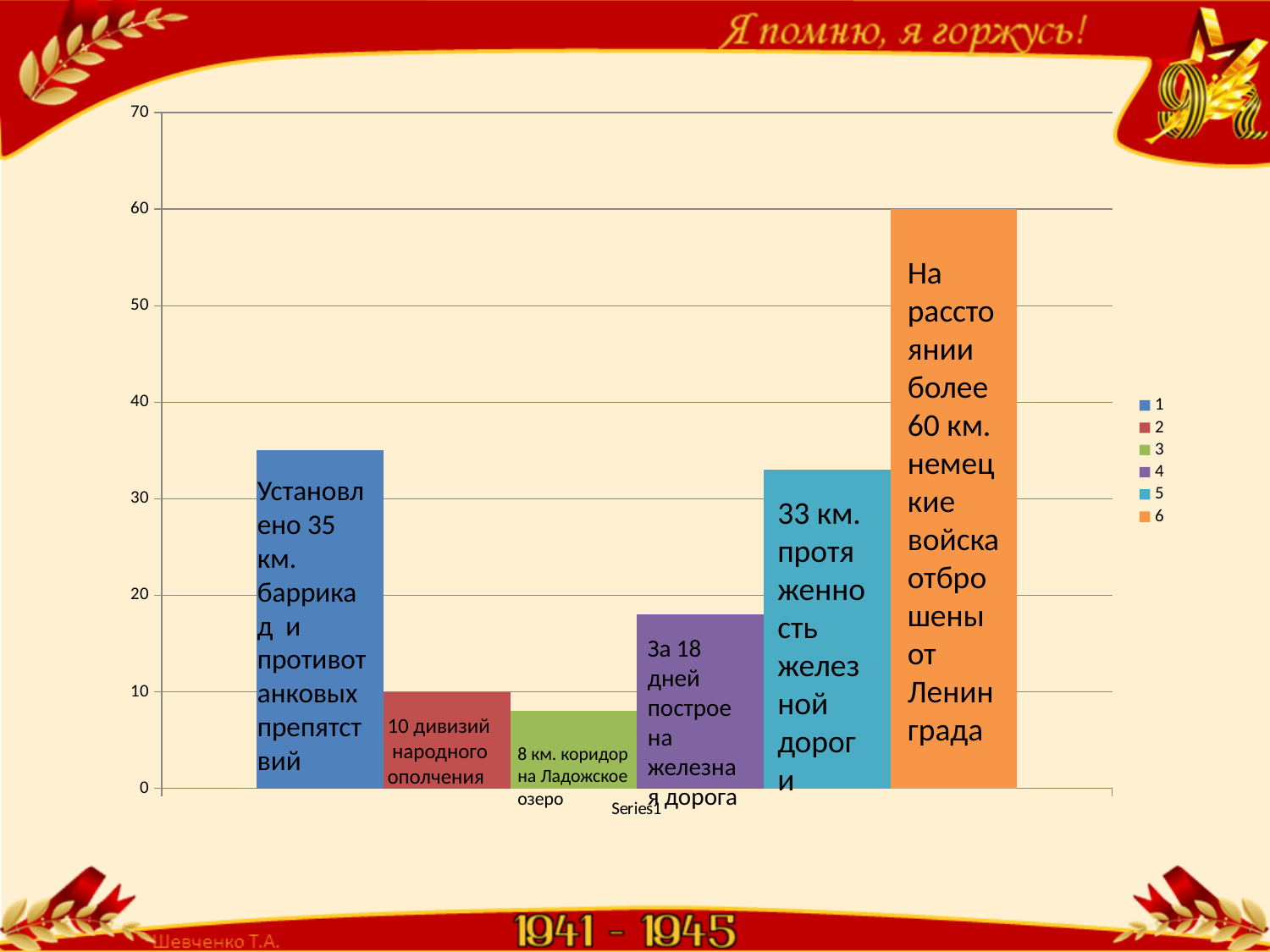
Is the value of the bar for series 1 (the blue bar) greater or less than 30? greater What is the value of the bar for series 6 (the orange bar)? 60 What is the value of the bar for series 2 (the red bar)? 10 Which bar is taller: series 4 (purple) or series 2 (red)? series 4 Is the value of the bar for series 5 (the teal bar) greater or less than 30? greater How many entries does the chart legend list? 6 Which legend series has the tallest bar in the chart? 6 How many bars are plotted in the chart? 6 Which legend series has the shortest bar in the chart? 3 What kind of chart is shown on the slide? bar chart Is the value of the bar for series 4 (the purple bar) greater or less than 20? less What is the difference between the value of the series 6 bar and the series 2 bar? 50